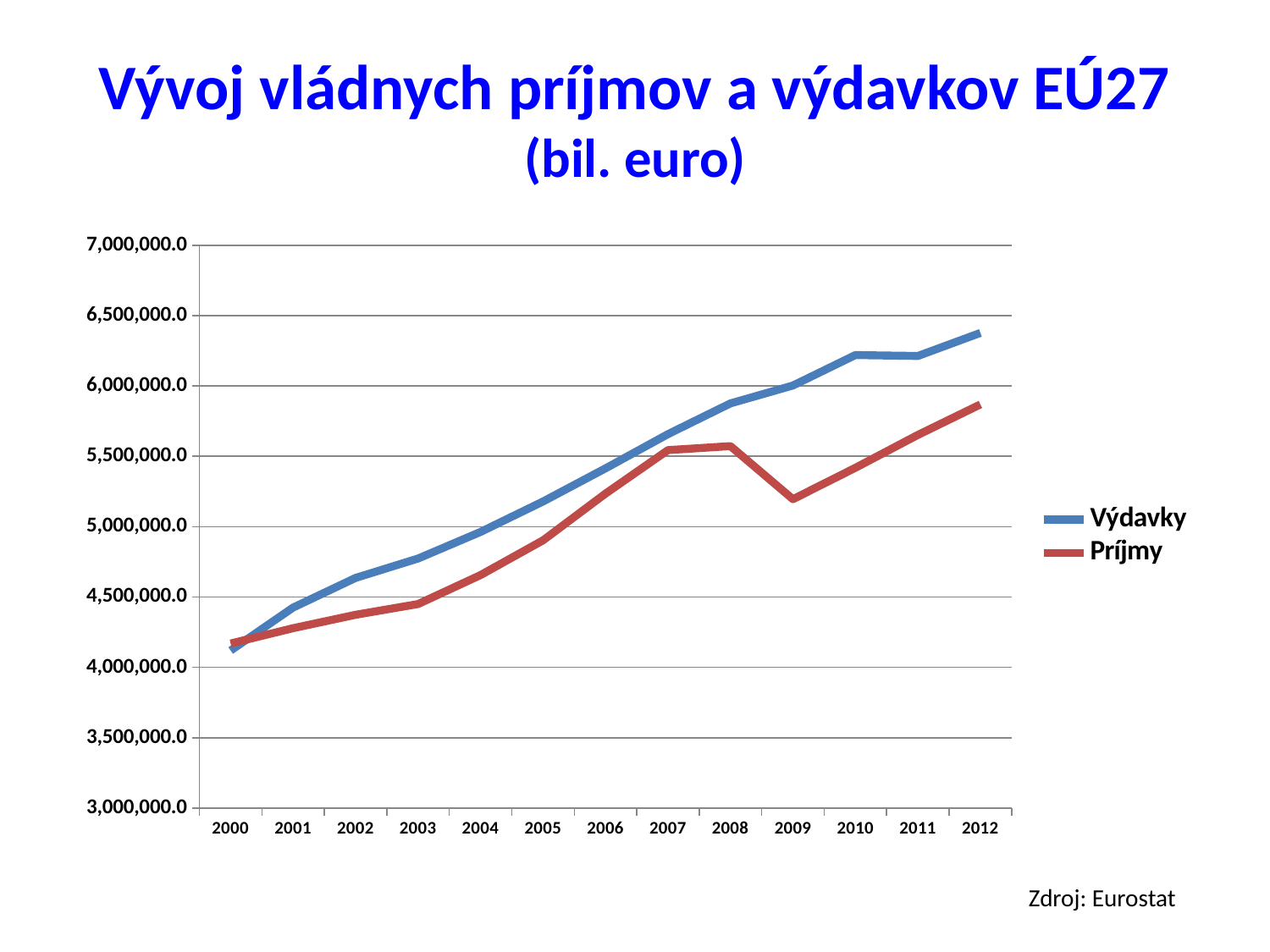
How many years are plotted along the x axis? 13 What kind of chart is shown on the slide? line chart In which year is the Výdavky value highest? 2012 How many series does the legend list? 2 Which series does the blue line represent? Výdavky In which year is the Príjmy value highest? 2012 Is the Výdavky value for 2012 greater or less than 6,000,000.0? greater In which year is the Výdavky value lowest? 2000 Is the Príjmy value for 2009 greater or less than 5,500,000.0? less What is the title of the chart? Vývoj vládnych príjmov a výdavkov EÚ27 (bil. euro) Which series has the larger value in 2012, Výdavky or Príjmy? Výdavky Is the Príjmy value for 2012 greater or less than 6,000,000.0? less